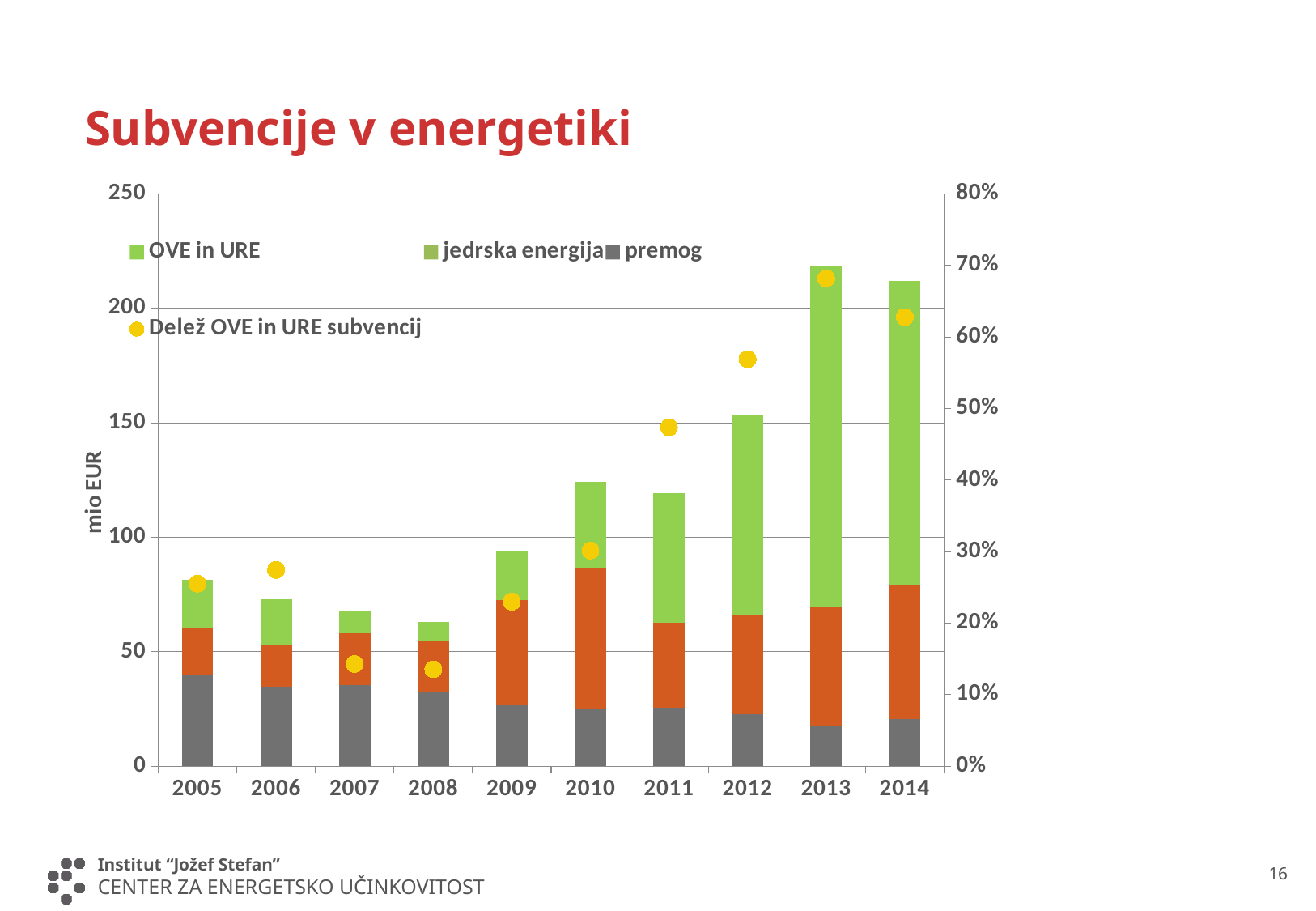
In which year is the total stacked bar the lowest? 2008 Is the total stacked bar for 2005 greater or less than 100 mio EUR? less Is the 'Delež OVE in URE subvencij' value for 2007 greater or less than 20%? less How many series does the chart legend list? 4 What is the label of the left vertical axis? mio EUR Is the total stacked bar for 2014 greater or less than 200 mio EUR? greater Which year has the larger total stacked bar, 2011 or 2012? 2012 In which year is the total stacked bar the highest? 2013 How many years are shown on the x axis of the chart? 10 What kind of chart is shown on the slide? bar chart (stacked, with a dot series on a secondary axis) Does the 'Delež OVE in URE subvencij' series rise or fall from 2008 to 2013? rise